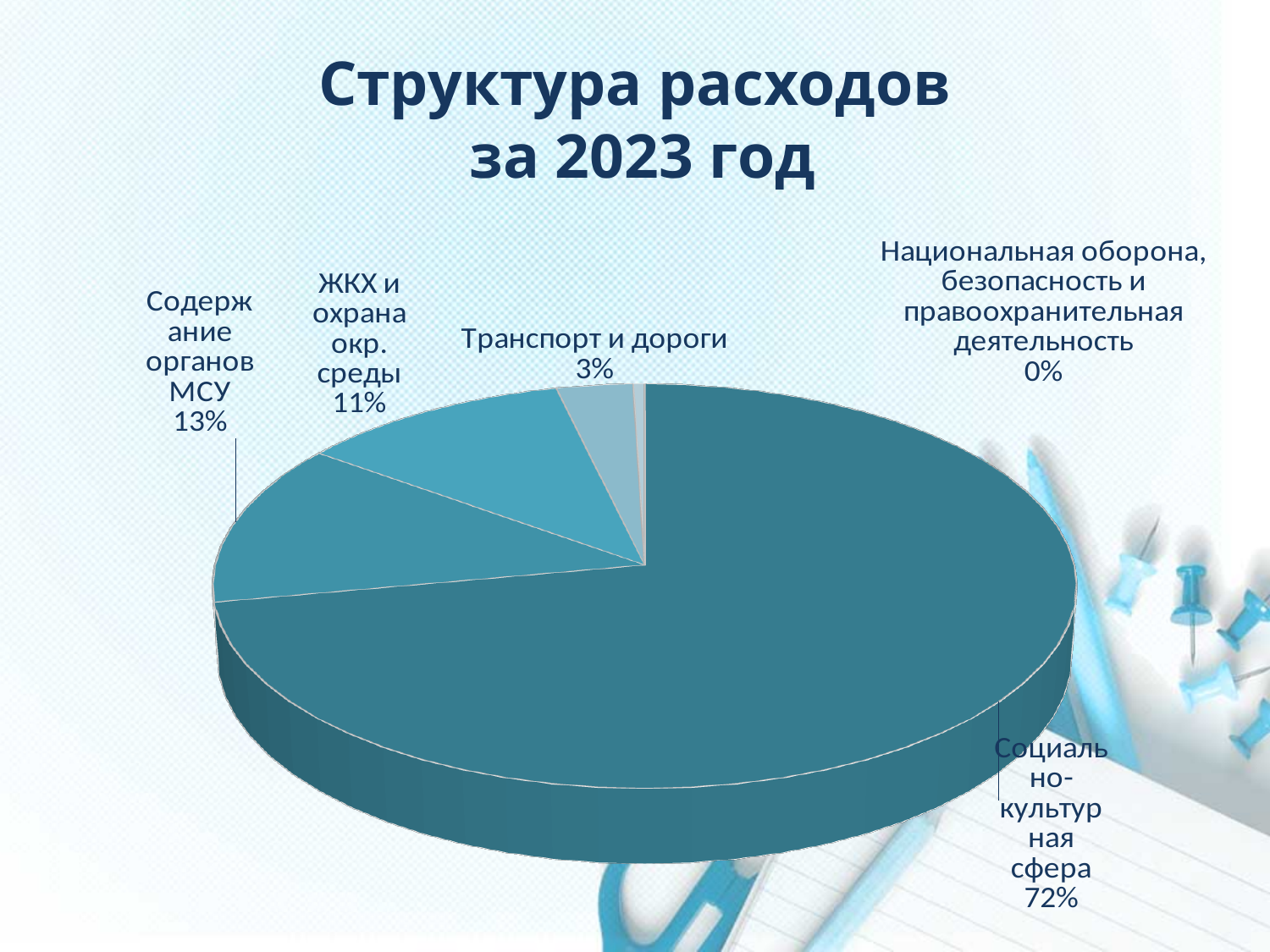
How many categories are shown in the pie chart? 5 Which category has the largest share of expenditures? Социально-культурная сфера What share of expenditures goes to Транспорт и дороги? 3% What share is shown for Национальная оборона, безопасность и правоохранительная деятельность? 0% What is the title of the chart? Структура расходов за 2023 год What is the difference in percentage points between Содержание органов МСУ and ЖКХ и охрана окр. среды? 2 percentage points What share of expenditures goes to Содержание органов МСУ? 13% What share of expenditures goes to Социально-культурная сфера? 72% Which is larger: the share for Содержание органов МСУ or the share for Транспорт и дороги? Содержание органов МСУ What share of expenditures goes to ЖКХ и охрана окр. среды? 11% What type of chart is shown on the slide? Pie chart Which category has the smallest share of expenditures? Национальная оборона, безопасность и правоохранительная деятельность